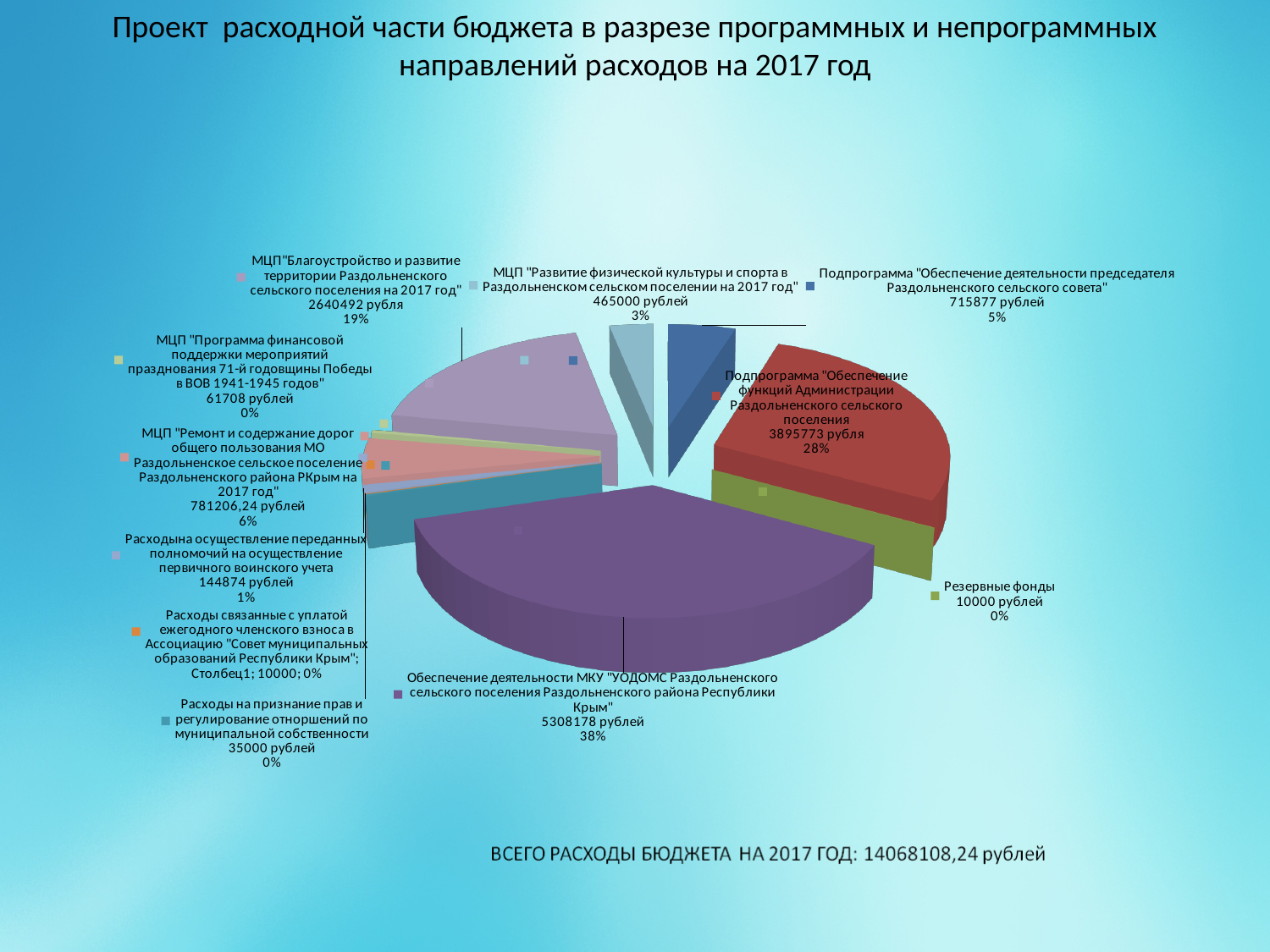
What is the value for "МЦП "Ремонт и содержание дорог общего пользования МО Раздольненское сельское поселение Раздольненского района РКрым на 2017 год""? 781206,24 рублей What is the value for "Подпрограмма "Обеспечение функций Администрации Раздольненского сельского поселения""? 3895773 рубля What share of the pie does "Обеспечение деятельности МКУ "УОДОМС Раздольненского сельского поселения Раздольненского района Республики Крым"" have? 38% Which is larger: the value for "Подпрограмма "Обеспечение деятельности председателя Раздольненского сельского совета"" or the value for "МЦП "Развитие физической культуры и спорта в Раздольненском сельском поселении на 2017 год""? Подпрограмма "Обеспечение деятельности председателя Раздольненского сельского совета" What is the difference between the value for "Обеспечение деятельности МКУ "УОДОМС..."" (5308178 рублей) and the value for "Подпрограмма "Обеспечение функций Администрации Раздольненского сельского поселения"" (3895773 рубля)? 1412405 Which category has the largest share of the pie? Обеспечение деятельности МКУ "УОДОМС Раздольненского сельского поселения Раздольненского района Республики Крым" What kind of chart is shown on the slide? Pie chart What is the value for "Расходы на осуществление переданных полномочий на осуществление первичного воинского учета"? 144874 рублей What is the total budget expenditure for 2017 stated on the slide? 14068108,24 рублей What is the value for "Резервные фонды"? 10000 рублей How many categories (slices) does the pie chart show? 11 What share of the pie does "МЦП "Благоустройство и развитие территории Раздольненского сельского поселения на 2017 год"" have? 19%